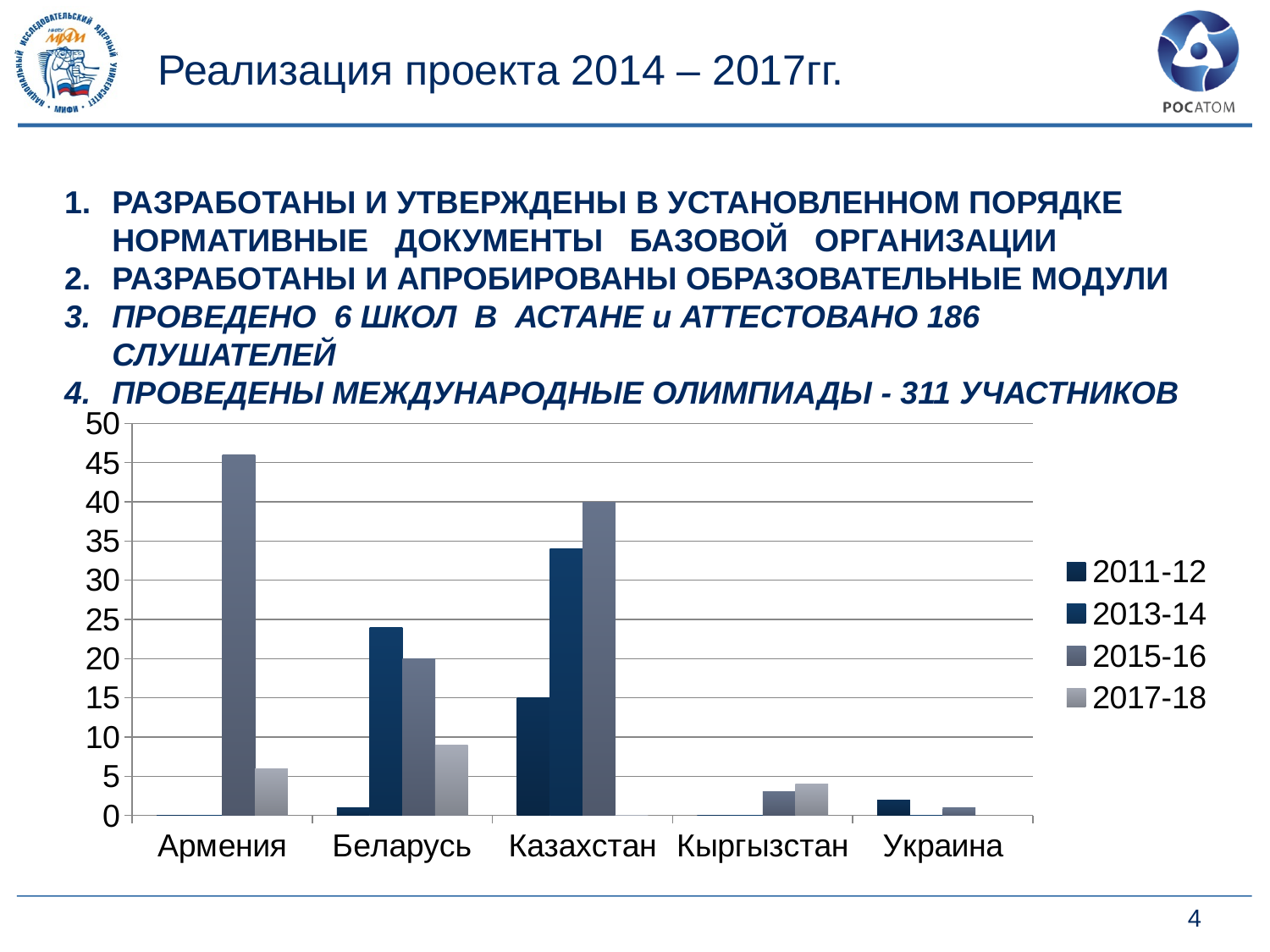
How many countries are shown on the x axis of the chart? 5 Which is larger for Казахстан: the 2011-12 value or the 2013-14 value? 2013-14 For which series does Армения have its tallest bar? 2015-16 What is the value for Беларусь in 2015-16? 20 How many series does the chart legend list? 4 Is the value for Армения in 2015-16 greater or less than 45? greater Which series is listed first in the chart legend? 2011-12 Which country has the tallest bar in the chart? Армения Is the value for Казахстан in 2013-14 greater or less than 30? greater Is the value for Беларусь in 2013-14 greater or less than 20? greater What is the value for Казахстан in 2015-16? 40 What kind of chart is shown on the slide? bar chart